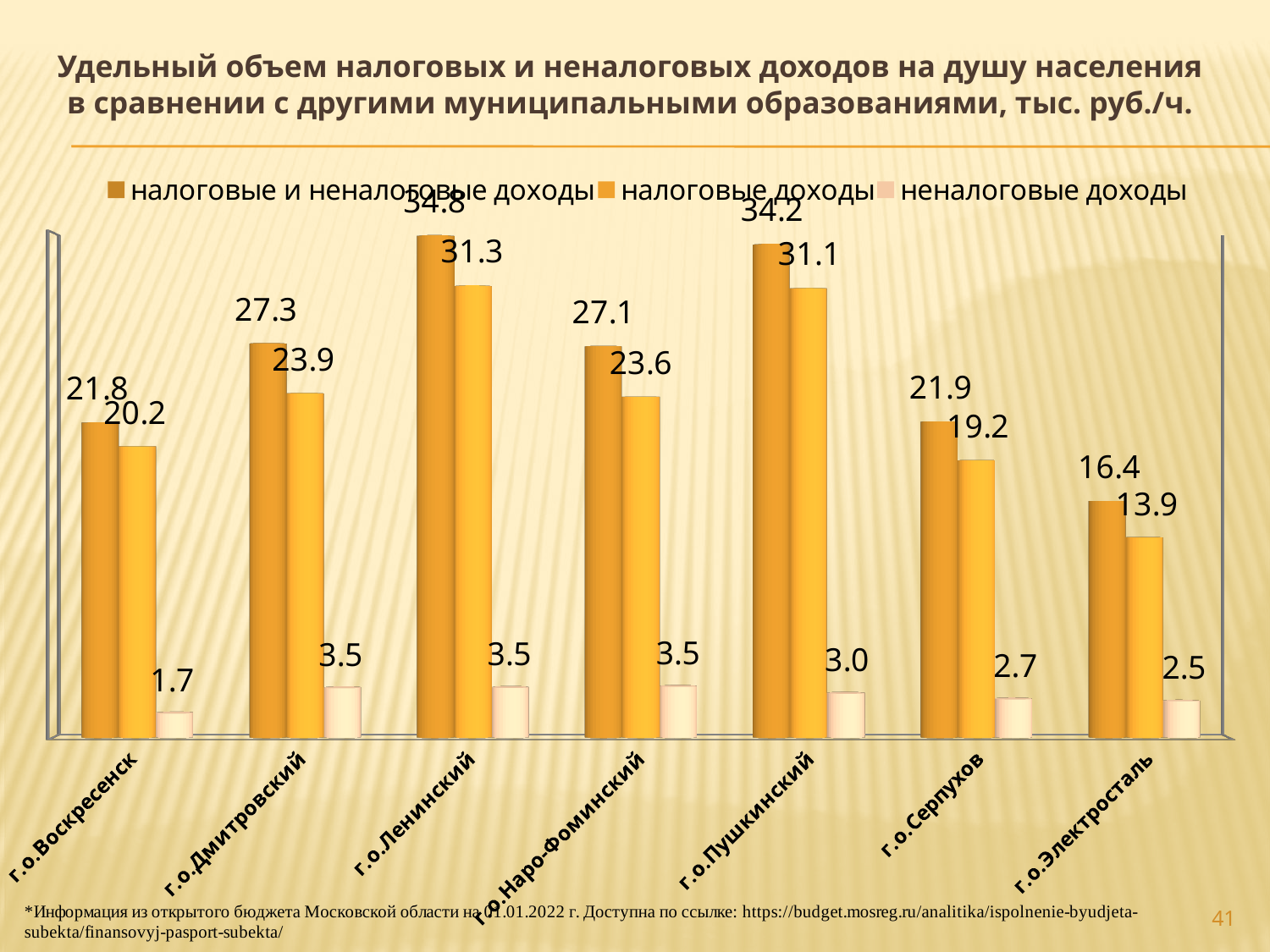
What is the difference between налоговые и неналоговые доходы and налоговые доходы for г.о.Пушкинский? 3.1 What is the value of неналоговые доходы for г.о.Воскресенск? 1.7 What kind of chart is shown on the slide? bar chart What is the value of неналоговые доходы for г.о.Дмитровский? 3.5 Which municipality has the highest value of налоговые и неналоговые доходы? г.о.Ленинский How many series does the legend list? 3 What is the value of налоговые доходы for г.о.Ленинский? 31.3 What is the difference in налоговые доходы between г.о.Дмитровский and г.о.Наро-Фоминский? 0.3 Which municipality has the lowest value of налоговые доходы? г.о.Электросталь How many municipalities are shown on the x axis? 7 Which is larger: неналоговые доходы for г.о.Серпухов or for г.о.Электросталь? г.о.Серпухов What is the value of налоговые и неналоговые доходы for г.о.Серпухов? 21.9